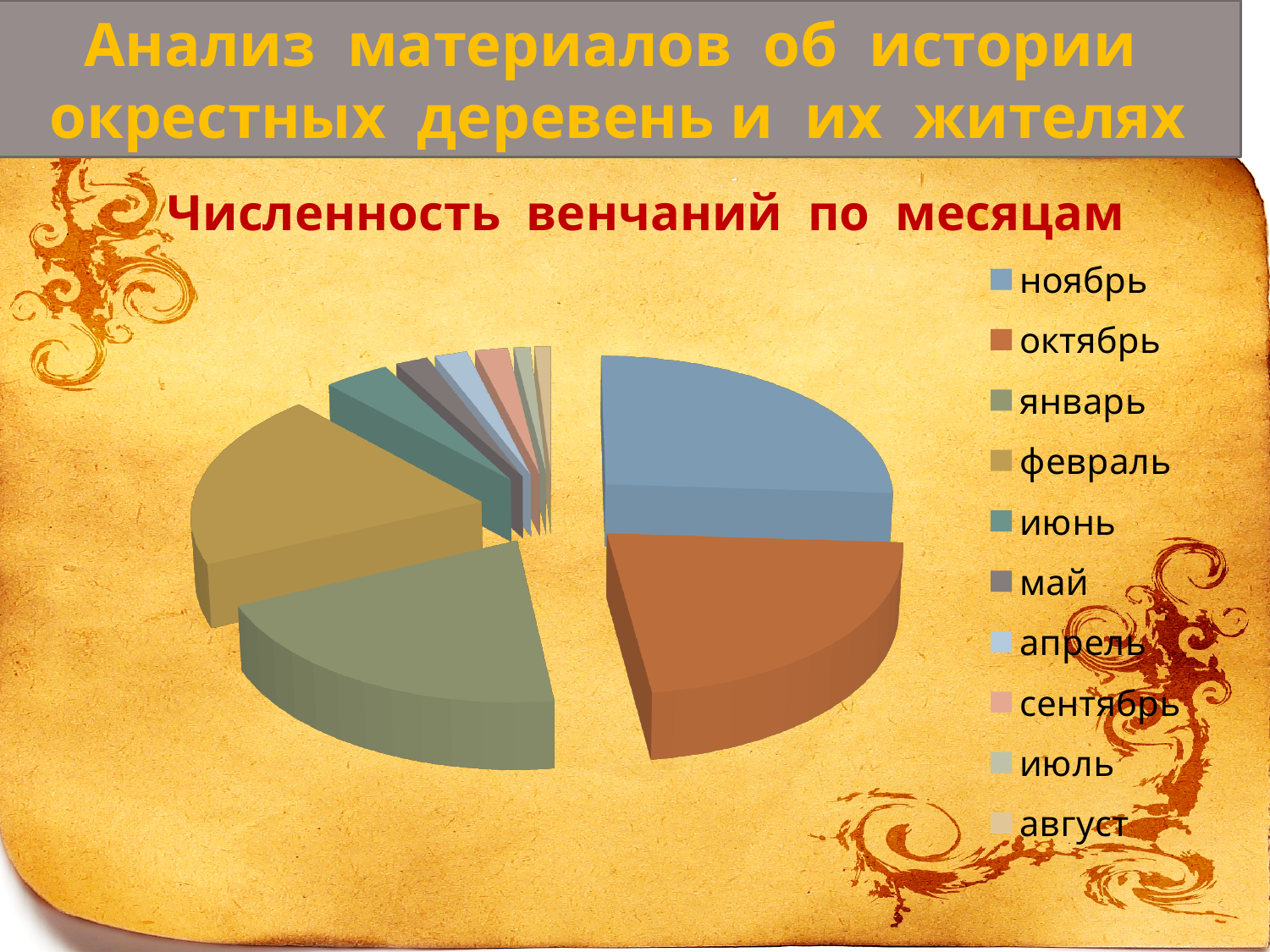
How many months does the legend list? 10 What kind of chart is shown on the slide? pie chart Which slice is larger, февраль or апрель? февраль What is the title of the chart? Численность венчаний по месяцам Which slice is smaller, ноябрь or август? август Which month is listed first in the legend? ноябрь Which slice is larger, ноябрь or июнь? ноябрь Which month has the largest slice of the pie? ноябрь